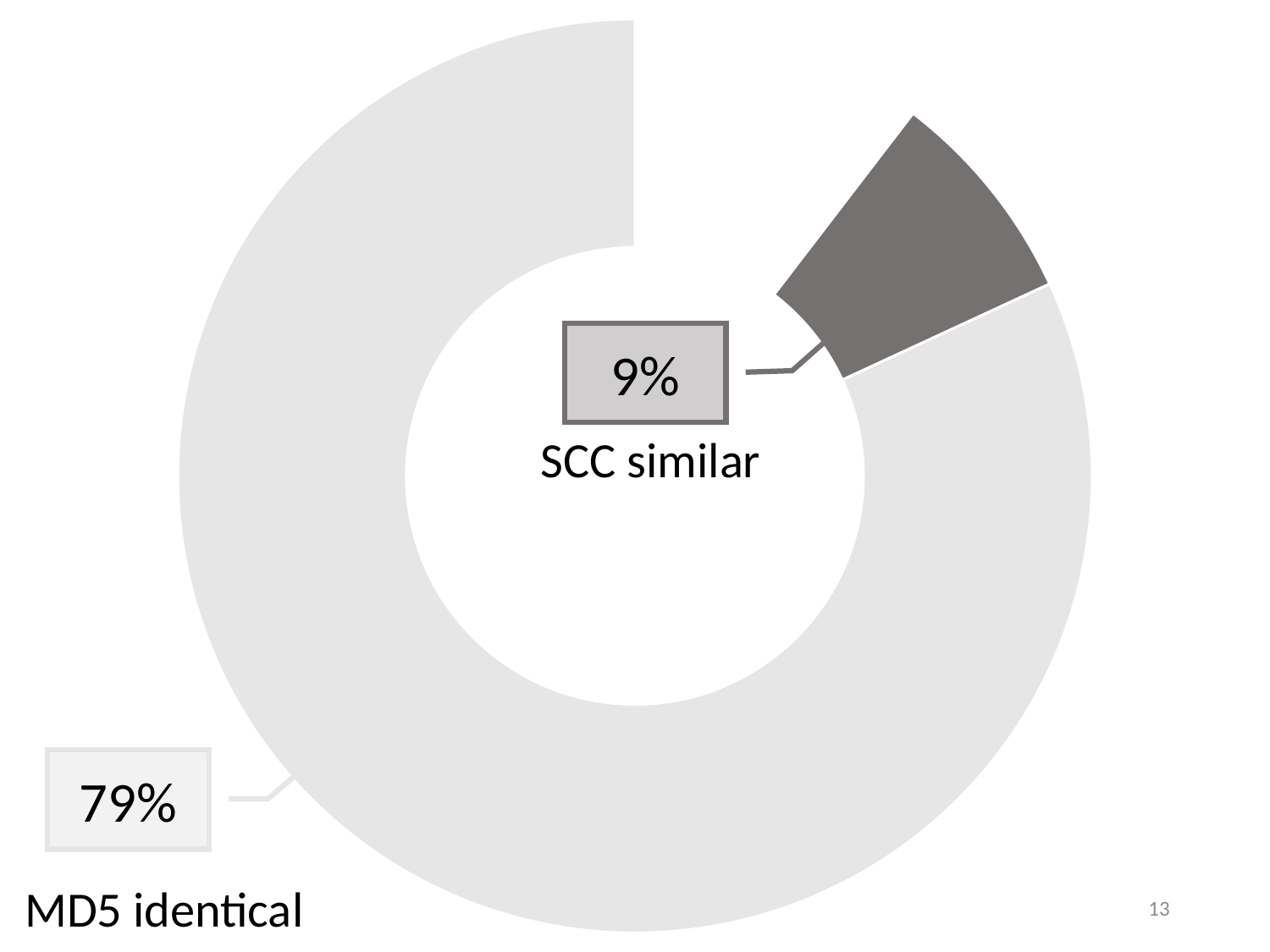
Which labelled slice is larger, MD5 identical or SCC similar? MD5 identical What colour is the SCC similar slice? Dark grey What percentage is shown for the MD5 identical slice? 79% Which of the two labelled slices has the largest share? MD5 identical What kind of chart is shown on the slide? Doughnut (pie) chart What is the combined share of the MD5 identical and SCC similar slices? 88% Which of the two labelled slices has the smallest share? SCC similar What is the difference in percentage points between the MD5 identical slice and the SCC similar slice? 70 percentage points What percentage is shown for the SCC similar slice? 9% Is the share for SCC similar greater or less than 25%? less Is the share for MD5 identical greater or less than 50%? greater